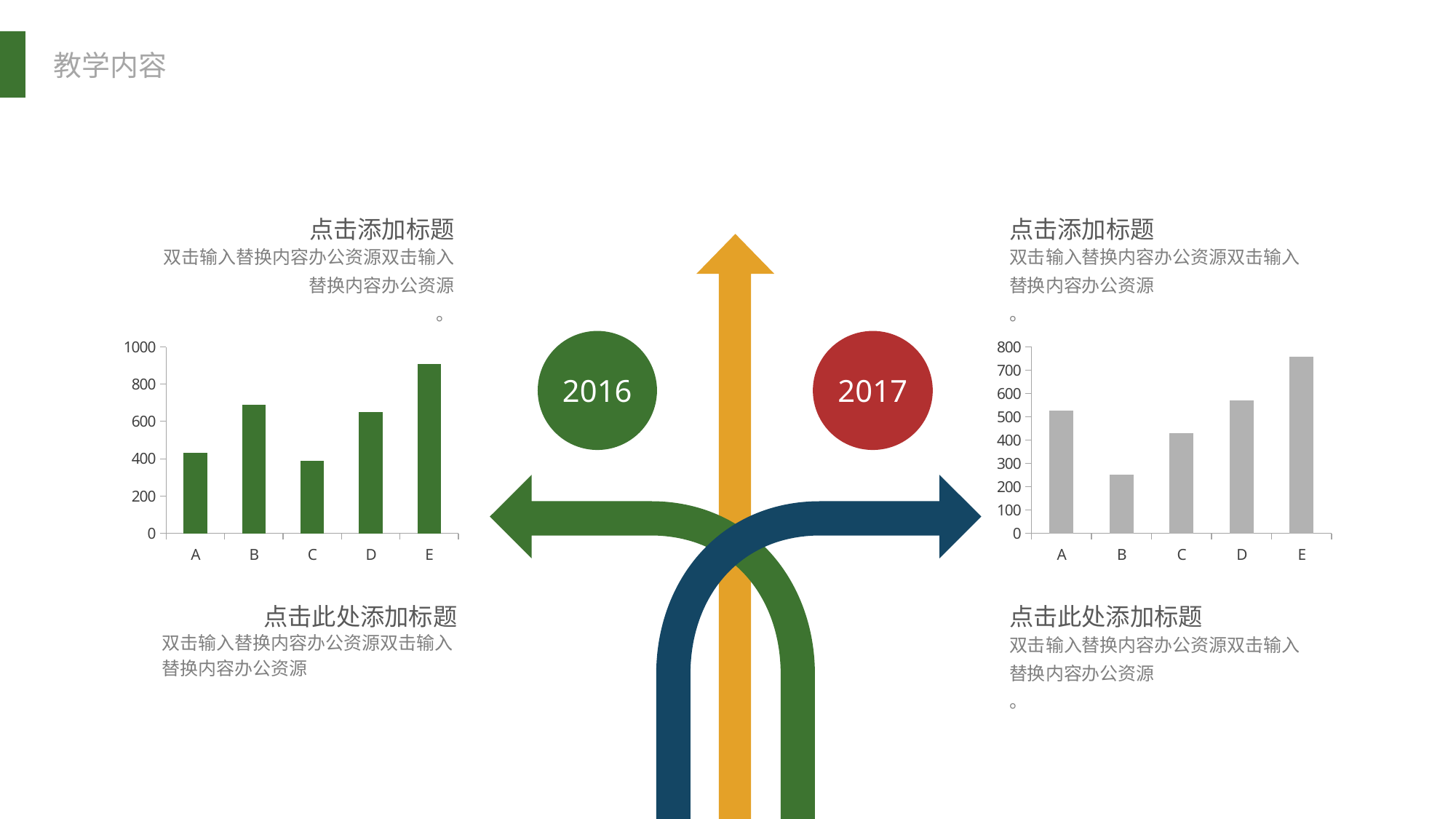
What kind of chart is the left chart on the slide? bar chart In the left chart, is the value for A greater or less than 600? less In the left chart, which category has the highest bar? E In the right chart, which category has the highest bar? E In the left chart, is the value for E greater or less than 800? greater In the right chart, is the value for B greater or less than 300? less In the right chart, which category has the lowest bar? B How many categories does the right chart show? 5 In the left chart, which category has the lowest bar? C What colour are the bars in the right chart? gray How many categories does the left chart show? 5 In the left chart, which is larger, the value for B or the value for D? B